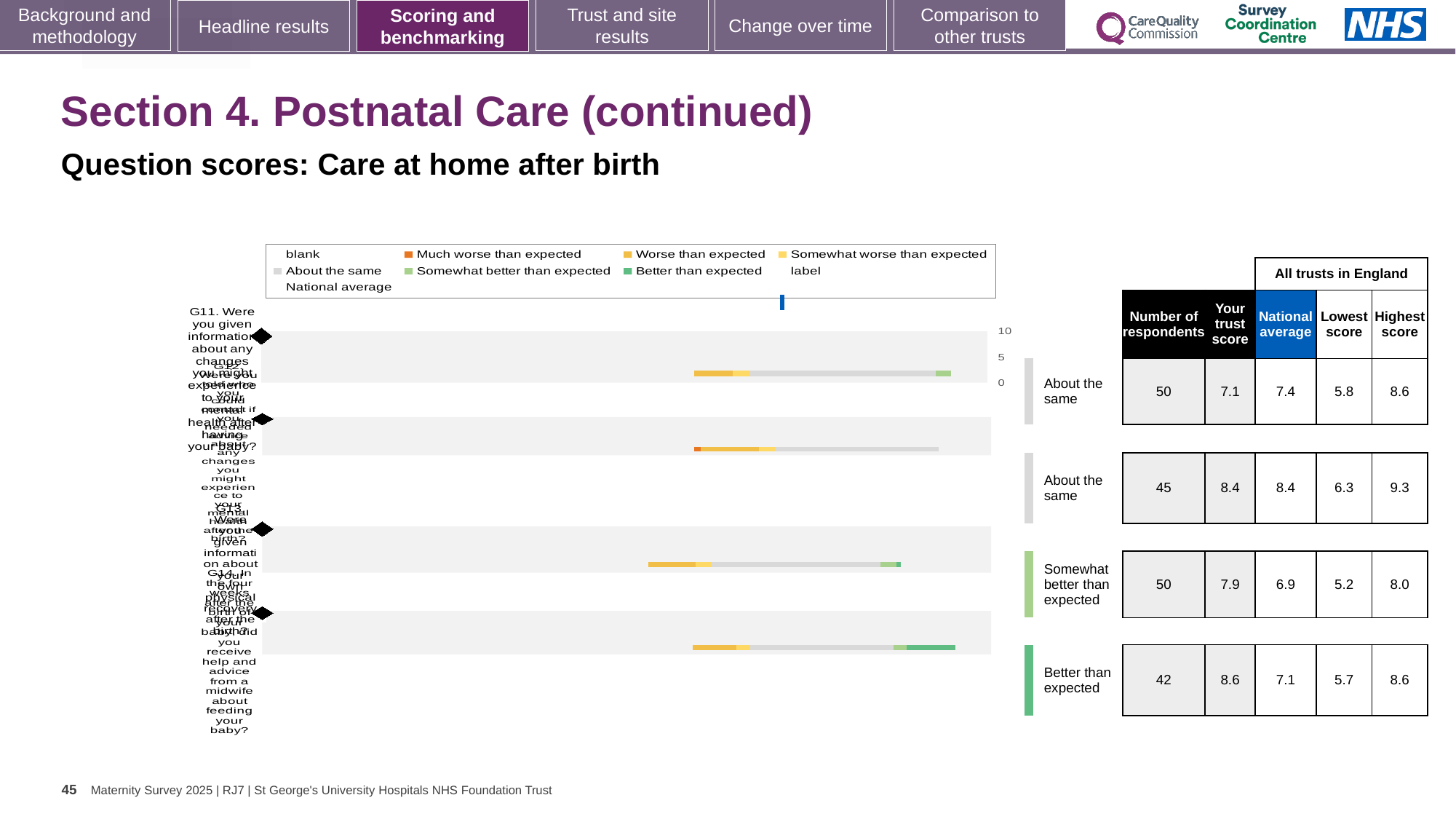
In the table beside the chart, what is the national average for the second row? 8.4 How many question rows (bars) are plotted in the chart? 4 In the table beside the chart, what is the number of respondents for the first (top) row? 50 For the third row of the table, which is larger: 'Your trust score' or the national average? Your trust score For the bottom row of the table, what is the difference between 'Your trust score' and the national average? 1.5 What colour does the chart legend use for 'Much worse than expected'? orange In the table beside the chart, what is 'Your trust score' for the bottom row? 8.6 In the table beside the chart, what is the highest score for the bottom row? 8.6 What is the highest tick value shown on the chart's score axis? 10 What kind of chart is shown on the slide? bar chart Which row in the table beside the chart has the highest 'Your trust score'? the bottom row (8.6) In the table beside the chart, what is the lowest score for the third row? 5.2